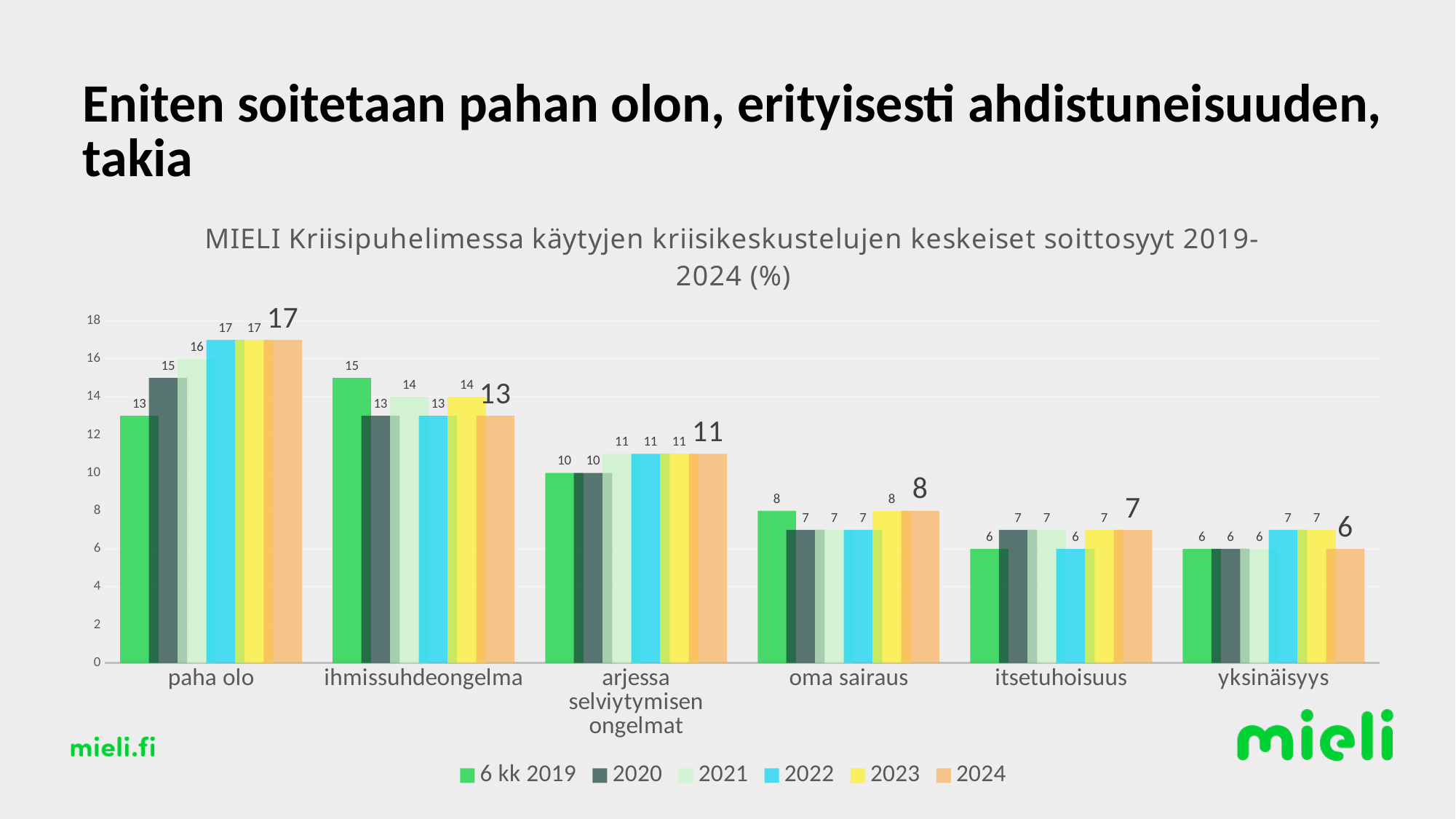
Which category has the lowest value in 2024? yksinäisyys Do the values for paha olo rise or fall from 6 kk 2019 to 2024? rise What is the value for yksinäisyys in 2022? 7 Which category has the highest value in 2024? paha olo How many categories are shown on the x axis? 6 What is the title of the chart? MIELI Kriisipuhelimessa käytyjen kriisikeskustelujen keskeiset soittosyyt 2019-2024 (%) Which is larger for oma sairaus: the value in 2020 or the value in 2024? 2024 What is the difference between the 2024 value and the 6 kk 2019 value for paha olo? 4 What is the value for ihmissuhdeongelma in 6 kk 2019? 15 How many series does the legend list? 6 What is the value for paha olo in 2024? 17 What kind of chart is shown on the slide? bar chart